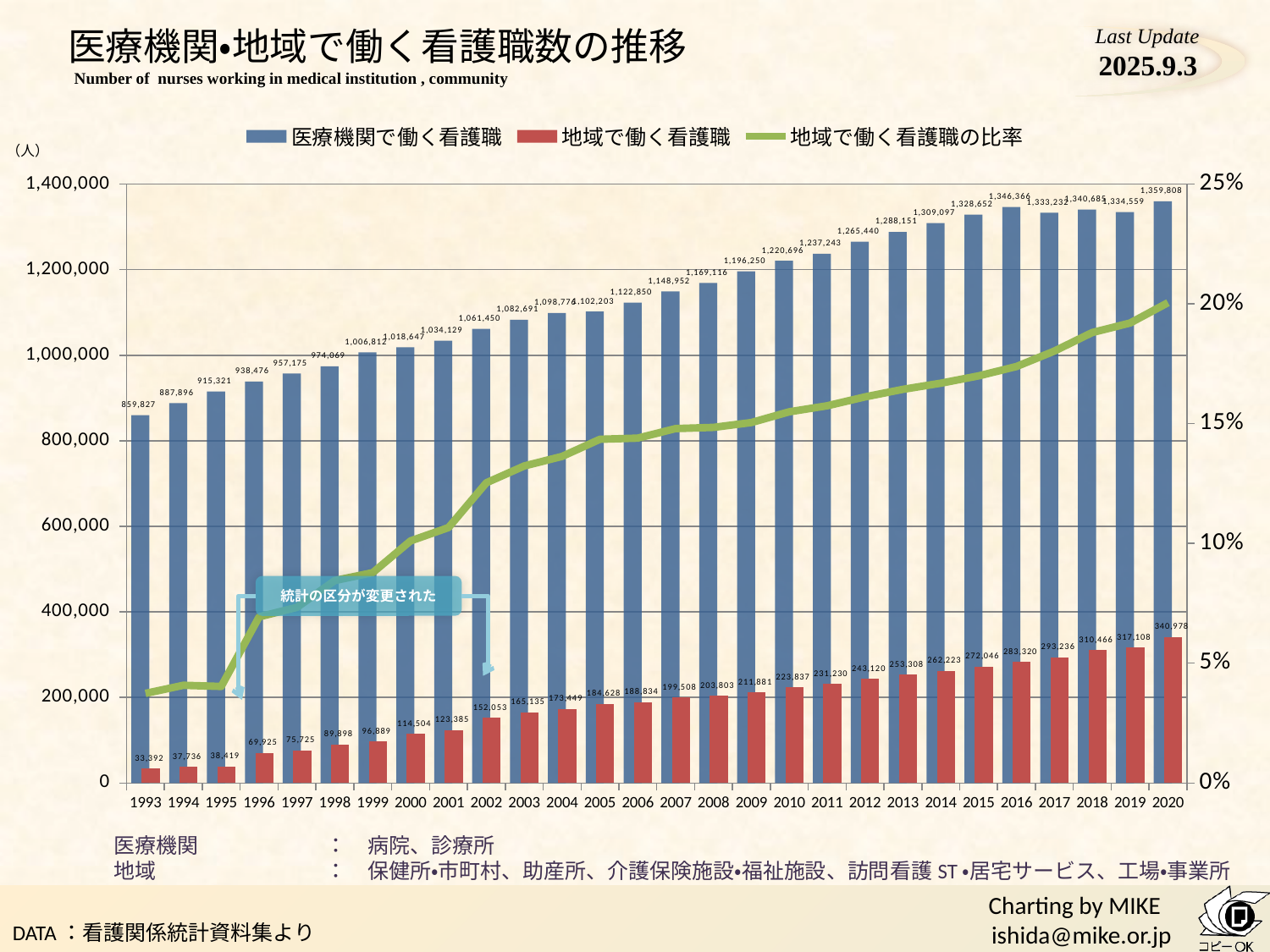
What is the difference between the 地域で働く看護職 values for 2020 and 2019? 23,870 What is the value for 医療機関で働く看護職 in 2020? 1,359,808 What is the value for 地域で働く看護職 in 2002? 152,053 Do the values for 地域で働く看護職 rise or fall from 1993 to 2020? rise Is the value of the 地域で働く看護職の比率 line for 2020 greater or less than 15%? greater How many years are shown on the x axis? 28 What is the value for 地域で働く看護職 in 1993? 33,392 What is the difference between the 医療機関で働く看護職 values for 2020 and 1993? 499,981 Which year has the larger value for 医療機関で働く看護職, 2016 or 2017? 2016 How many series does the legend list? 3 In which year is the value for 地域で働く看護職 lowest? 1993 In which year is the value for 医療機関で働く看護職 highest? 2020